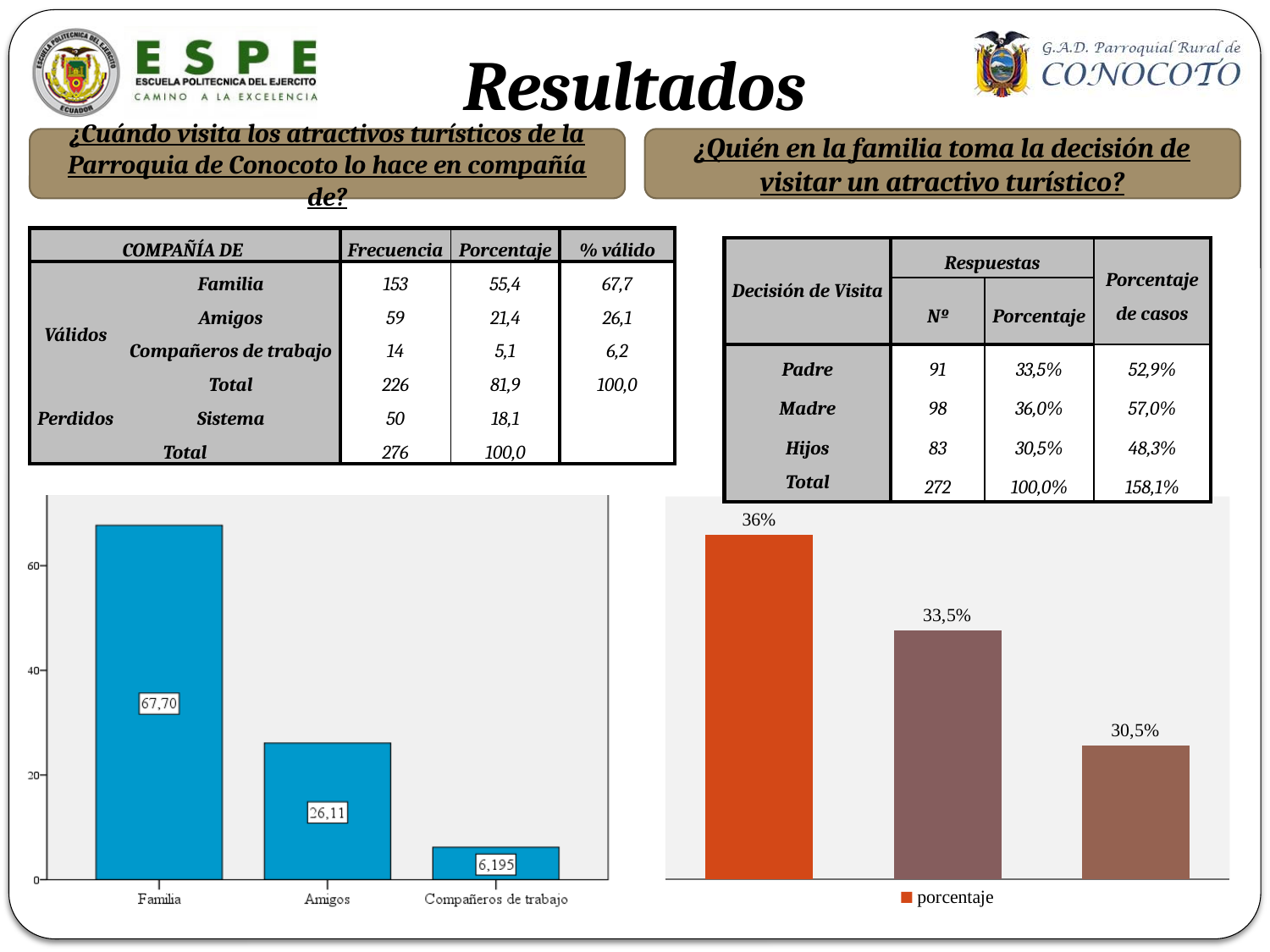
On the left chart, what is the difference between the values for Familia and Amigos? 41,59 On the left chart, how many categories are shown on the x axis? 3 On the left chart, what is the value for Compañeros de trabajo? 6,195 On the left chart, what is the value for Familia? 67,70 On the right chart, what is the highest value shown on a data label? 36% On the right chart, what series name does the legend show? porcentaje On the left chart, which category has the lowest value? Compañeros de trabajo On the right chart, what is the lowest value shown on a data label? 30,5% On the left chart, what is the value for Amigos? 26,11 On the left chart, is the value for Amigos greater or less than 20? greater On the left chart, which category has the highest value? Familia What kind of chart is the left chart? bar chart